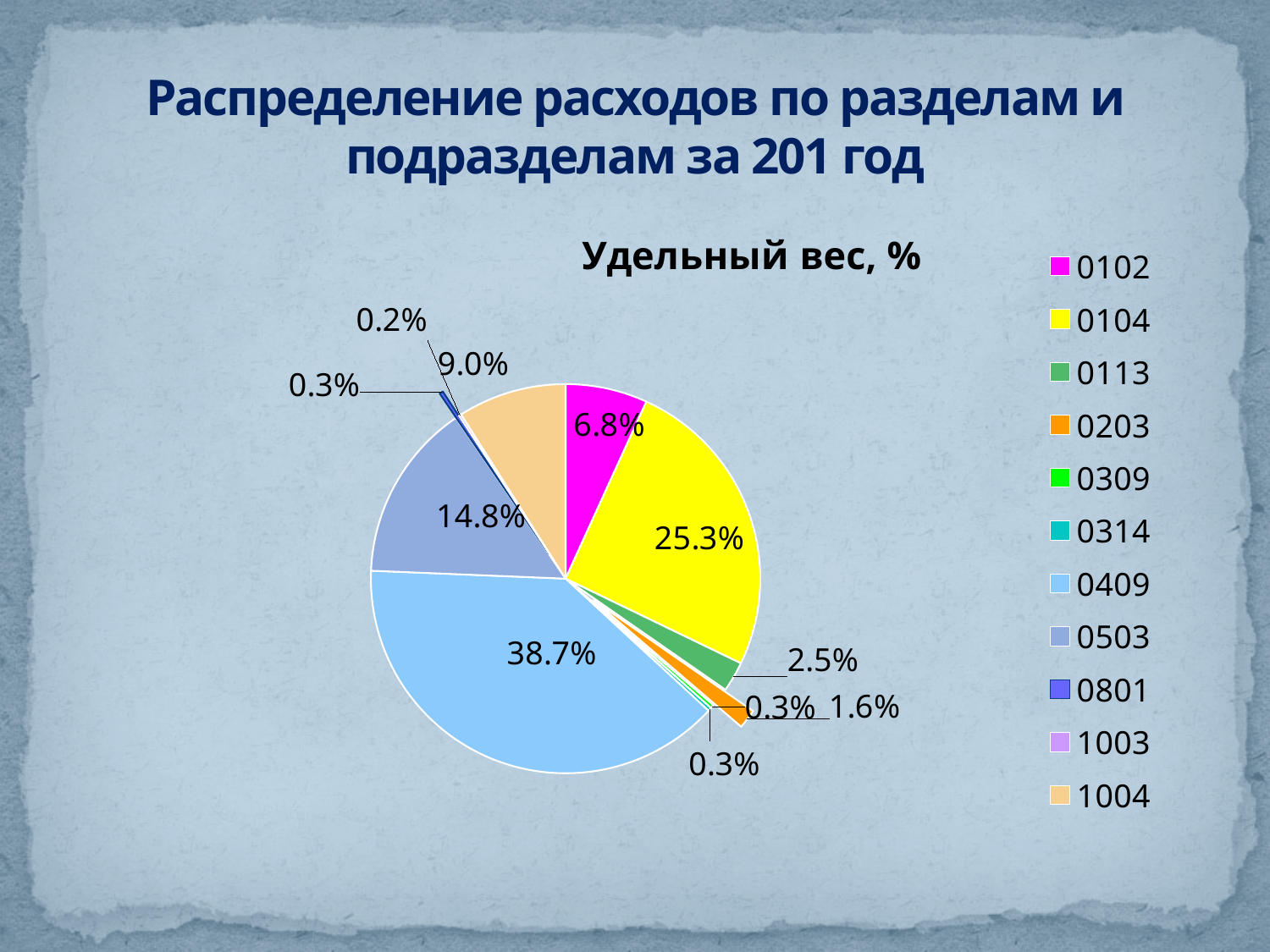
Which category has the smallest slice of the pie? 1003 What is the value shown for category 0104? 25.3% What type of chart is shown on the slide? Pie chart What is the difference between the shares of 0409 and 0104? 13.4% Which category has the largest slice of the pie? 0409 What is the value shown for category 0113? 2.5% Which has a larger share, 0503 or 1004? 0503 What is the value shown for category 1004? 9.0% How many categories are listed in the legend? 11 What is the value shown for category 0102? 6.8% What is the value shown for category 0503? 14.8% What share of the pie does category 0409 have? 38.7%